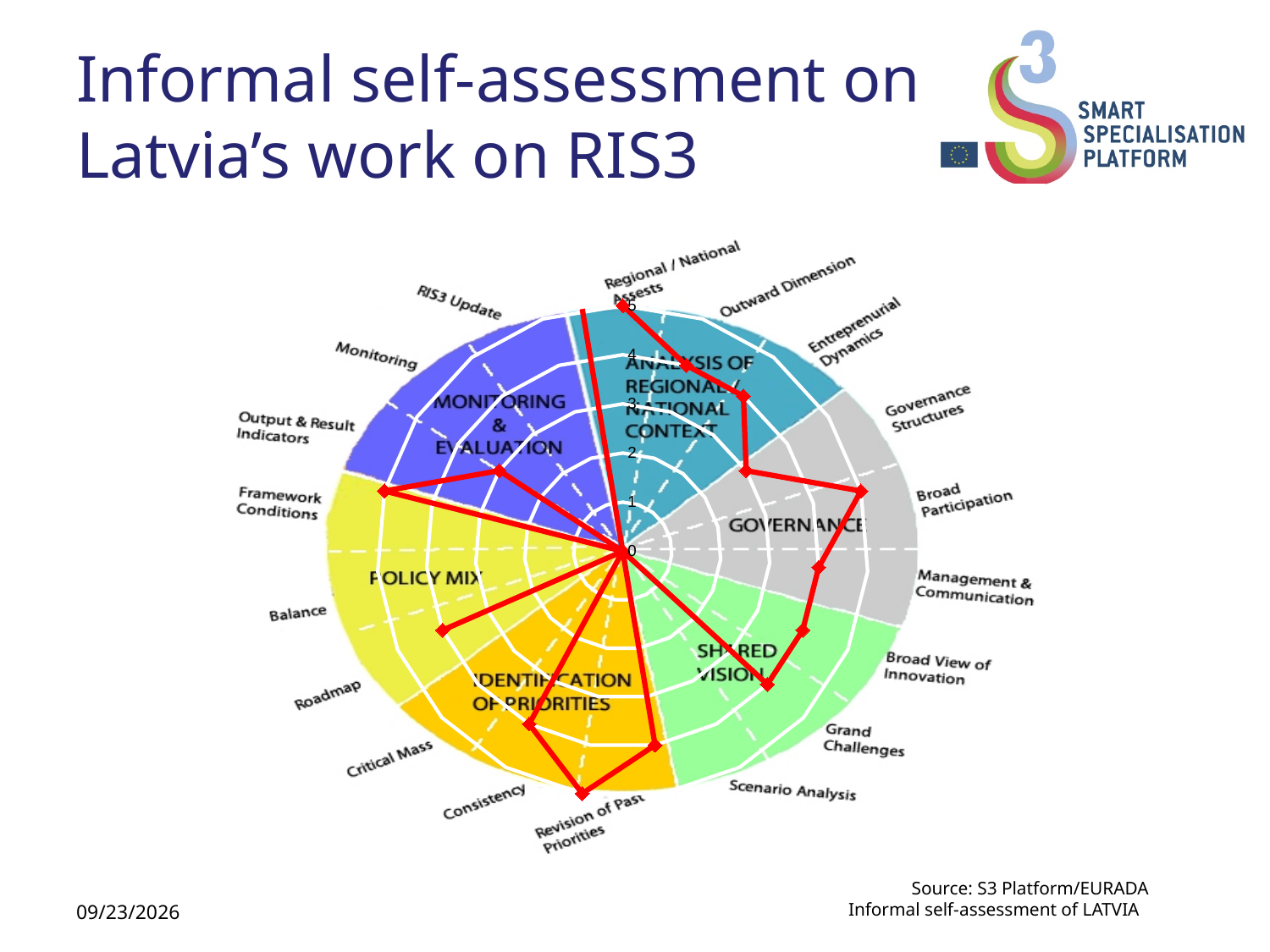
Is the value for Governance Structures greater or less than 4? less Which is larger, the value for Regional / National Assets or the value for Scenario Analysis? Regional / National Assets How many categories are plotted around the radar chart? 18 Which is larger, the value for Consistency or the value for Roadmap? Consistency How many coloured sections (such as GOVERNANCE and SHARED VISION) is the wheel behind the radar chart divided into? 6 Is the value for Consistency greater or less than 3? greater Is the value for Regional / National Assets greater or less than 4? greater What kind of chart is shown on the slide? radar chart What is the highest value shown on the radar chart's axis scale? 5